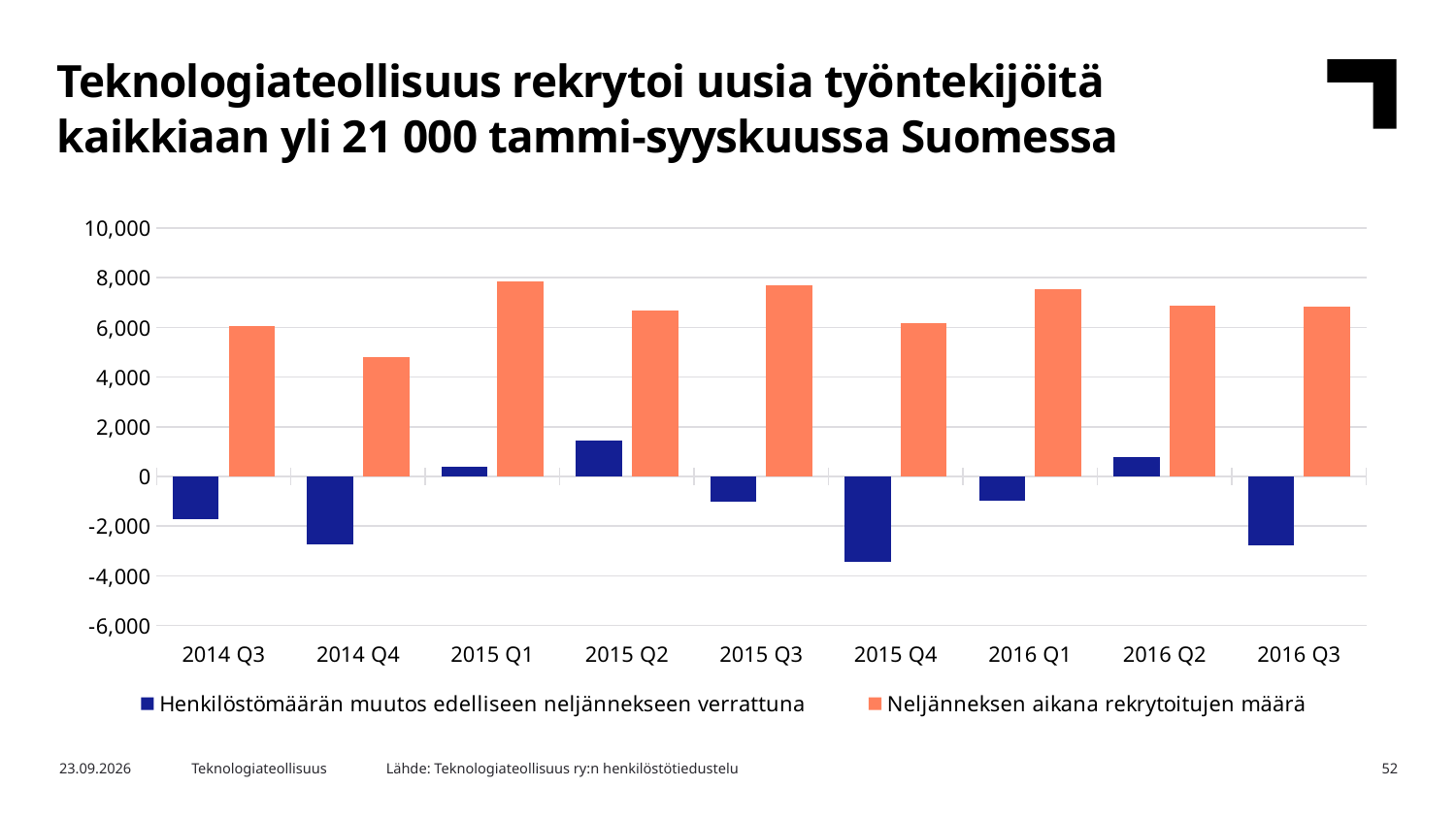
Is the value for 'Henkilöstömäärän muutos edelliseen neljännekseen verrattuna' in 2015 Q4 greater or less than -2,000? less Is the value for 'Neljänneksen aikana rekrytoitujen määrä' in 2014 Q4 greater or less than 6,000? less What kind of chart is shown on the slide? bar chart In which quarter is the value for 'Neljänneksen aikana rekrytoitujen määrä' lowest? 2014 Q4 How many series does the chart legend list? 2 Which quarter has the larger value for 'Henkilöstömäärän muutos edelliseen neljännekseen verrattuna', 2015 Q2 or 2016 Q2? 2015 Q2 Which series is shown in orange in the chart? Neljänneksen aikana rekrytoitujen määrä In which quarter is the value for 'Henkilöstömäärän muutos edelliseen neljännekseen verrattuna' highest? 2015 Q2 In which quarter is the value for 'Henkilöstömäärän muutos edelliseen neljännekseen verrattuna' lowest? 2015 Q4 Which quarter has the larger value for 'Neljänneksen aikana rekrytoitujen määrä', 2014 Q3 or 2014 Q4? 2014 Q3 Is the value for 'Neljänneksen aikana rekrytoitujen määrä' in 2015 Q1 greater or less than 6,000? greater How many quarters are shown on the x axis of the chart? 9